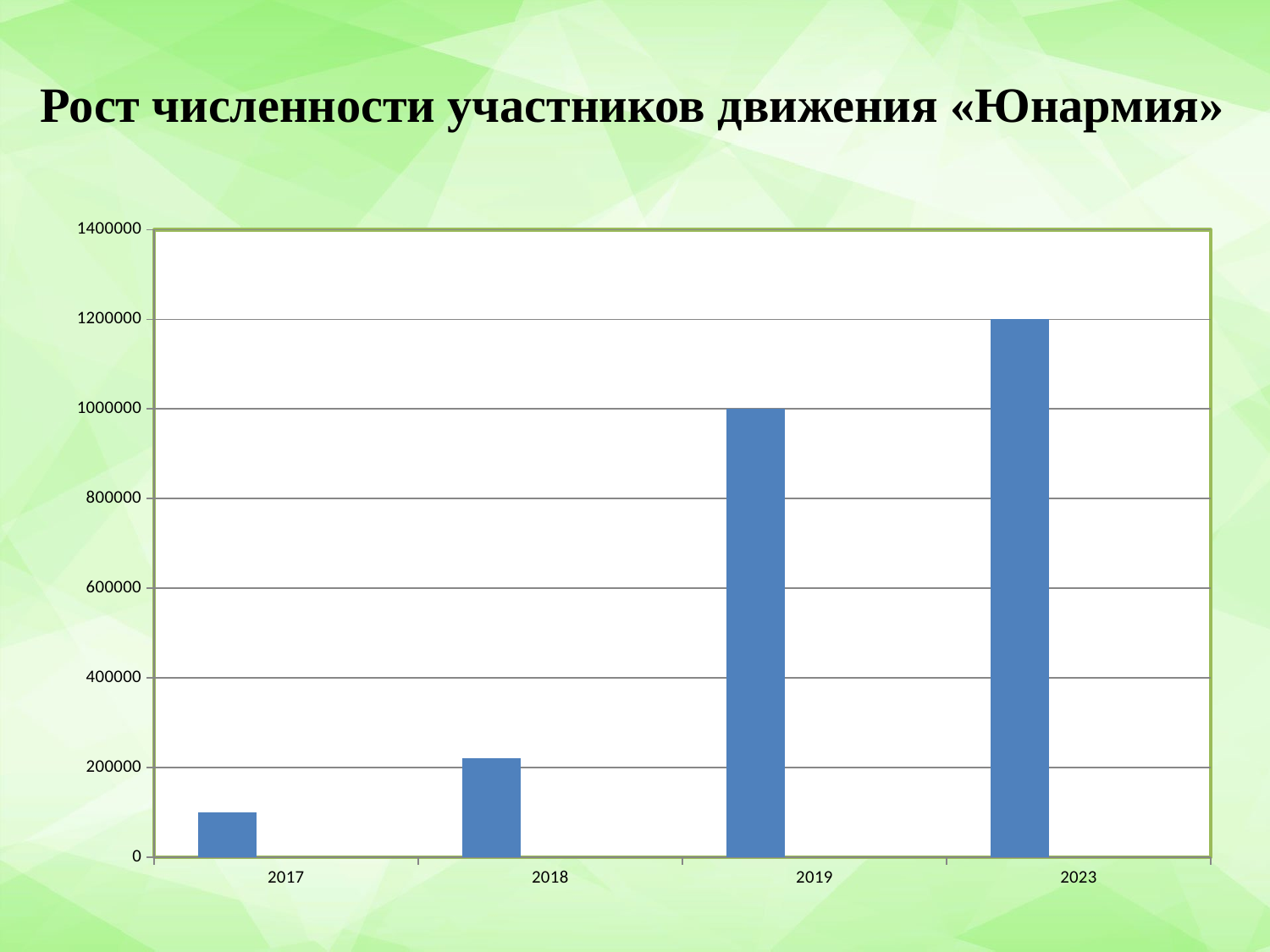
What is the difference between the values for 2023 and 2019? 200000 Is the value for 2017 greater or less than 200000? less What is the value for 2019? 1000000 What is the title of the chart? Рост численности участников движения «Юнармия» Which is larger, the value for 2018 or the value for 2019? 2019 How many years (categories) are shown on the x axis? 4 Which year has the lowest value? 2017 What type of chart is shown on the slide? bar chart Do the values rise or fall from 2017 to 2023? rise Is the value for 2018 greater or less than 400000? less Which year has the highest value? 2023 What is the value for 2023? 1200000